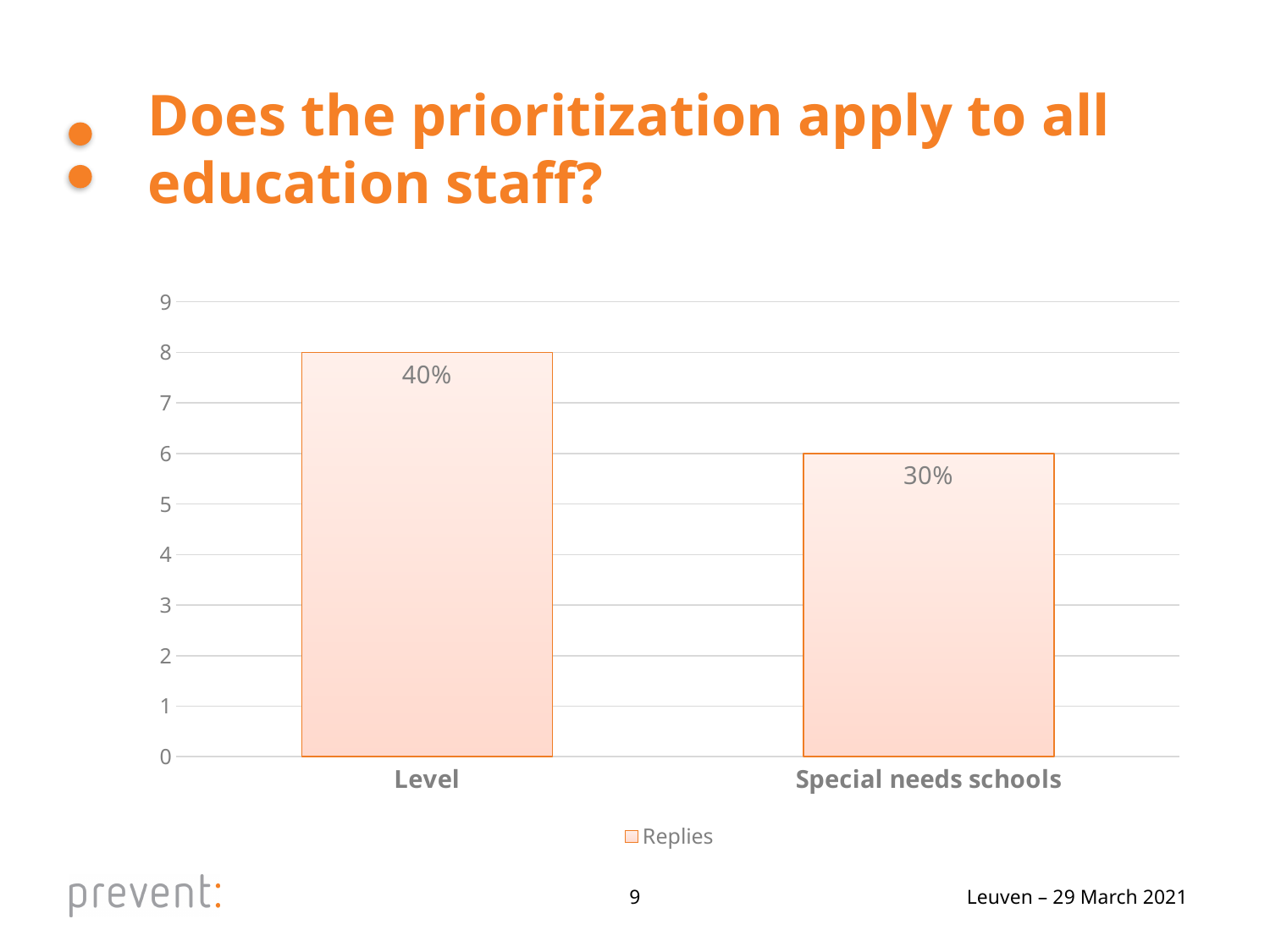
What kind of chart is shown on the slide? bar chart How many series does the legend list? 1 What data label is shown on the bar for Level? 40% Which category has the highest bar? Level Which category has the lowest bar? Special needs schools What is the difference between the data labels for Level and Special needs schools? 10% On the y axis, what value does the top of the Level bar reach? 8 What data label is shown on the bar for Special needs schools? 30% Is the bar for Special needs schools greater or less than 7 on the y axis? less How many categories are shown on the x axis? 2 Which is larger, the bar for Level or the bar for Special needs schools? Level On the y axis, what value does the top of the Special needs schools bar reach? 6